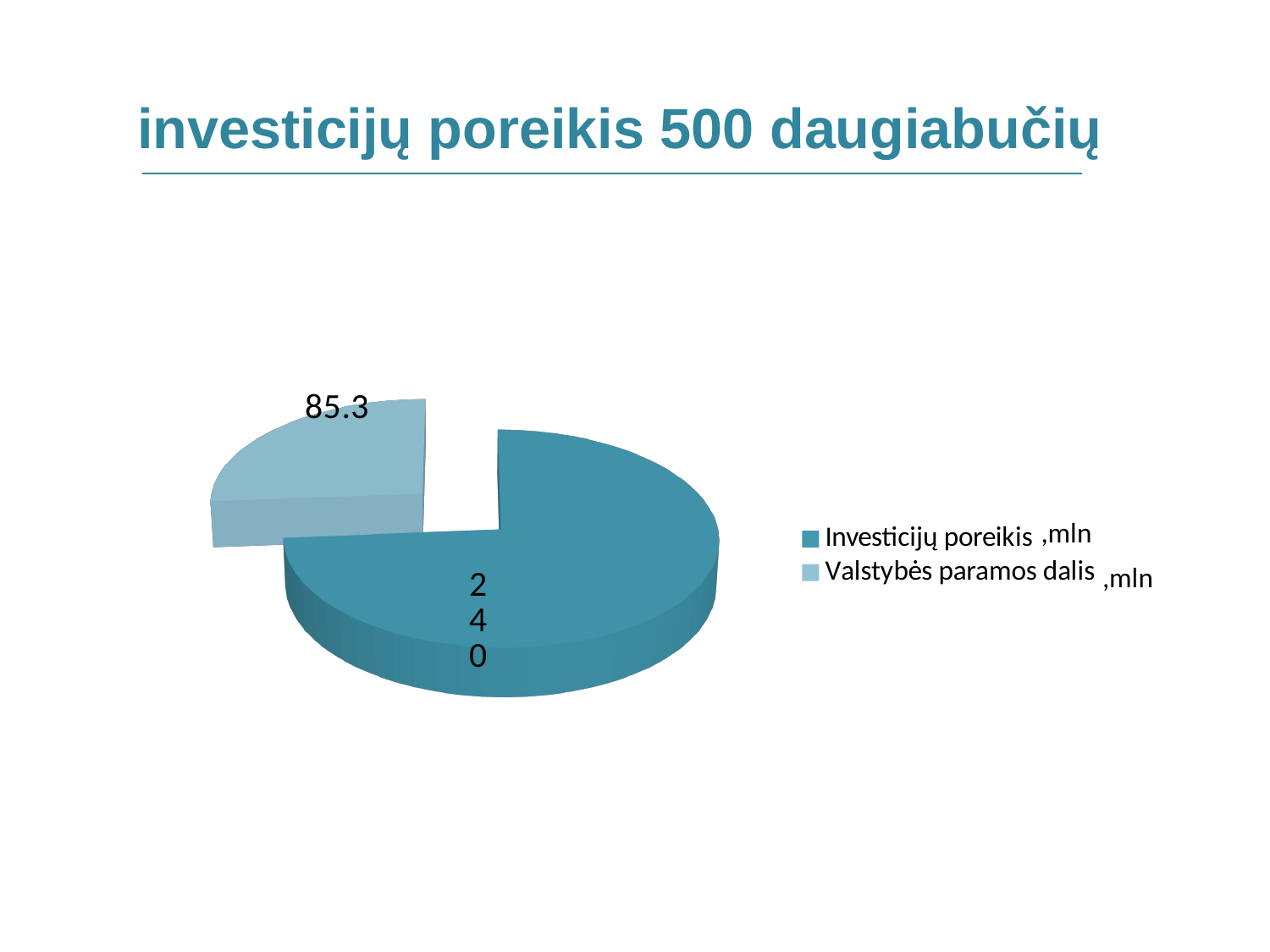
What is the total of the two slices in the pie chart? 325.3 What is the title of the slide containing the pie chart? investicijų poreikis 500 daugiabučių Which slice is the smallest in the pie chart? Valstybės paramos dalis What unit is shown next to the legend entries? mln What is the value of the Investicijų poreikis slice? 240 How many slices does the pie chart have? 2 Which slice is the largest in the pie chart? Investicijų poreikis What is the difference between the Investicijų poreikis value and the Valstybės paramos dalis value? 154.7 What is the value of the Valstybės paramos dalis slice? 85.3 Which is larger, Investicijų poreikis or Valstybės paramos dalis? Investicijų poreikis What kind of chart is shown on the slide? pie chart How many entries does the legend list? 2